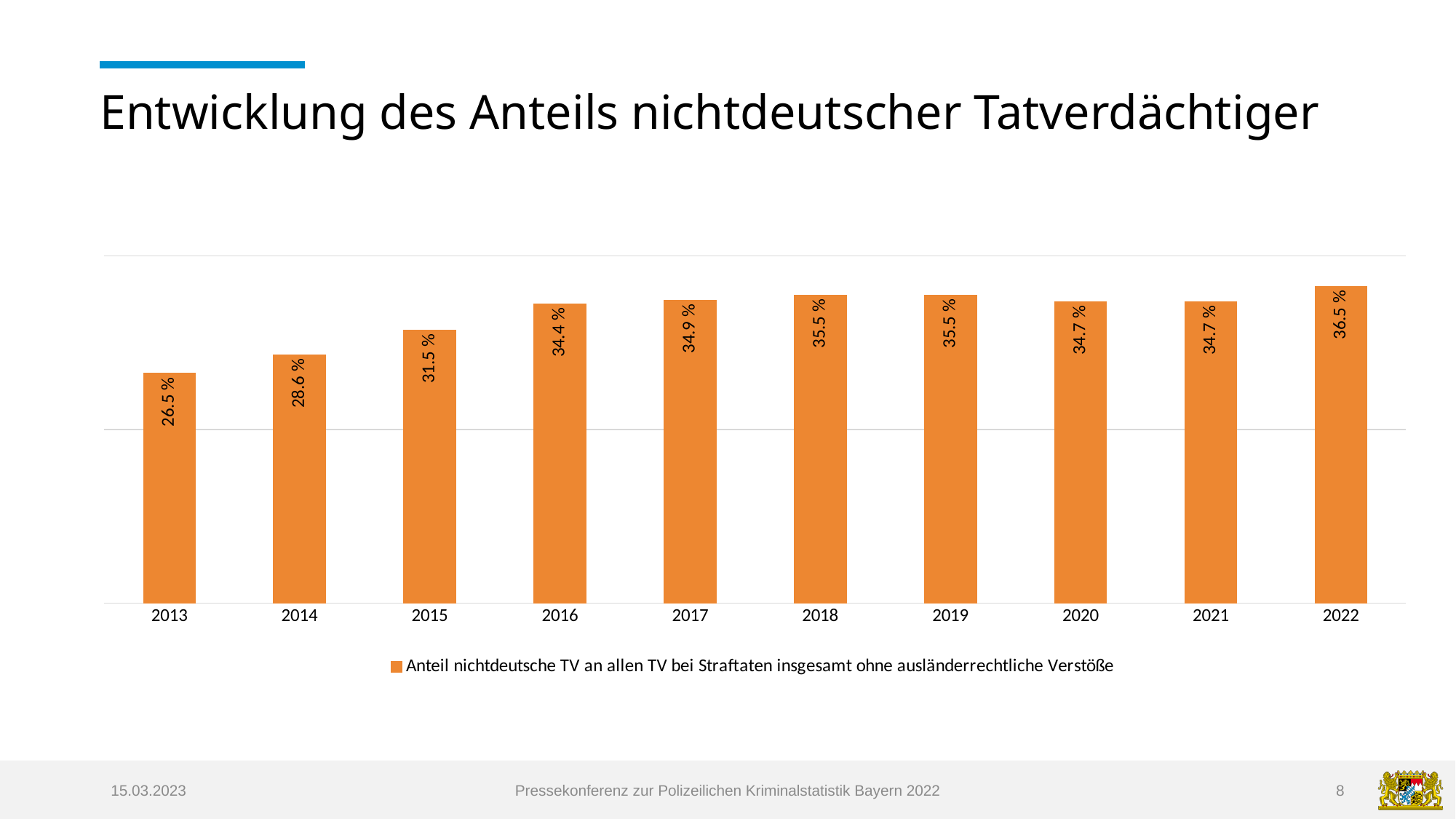
What kind of chart is shown on the slide? Bar chart How many series does the legend list? 1 What is the value for 2022? 36.5 % Do the values generally rise or fall from 2013 to 2022? Rise How many years are shown on the x axis? 10 Which is larger, the value for 2016 or the value for 2015? 2016 Which year has the lowest value? 2013 What is the difference between the values for 2022 and 2013? 10.0 percentage points What is the value for 2013? 26.5 % What is the difference between the values for 2015 and 2014? 2.9 percentage points Which year has the highest value? 2022 What is the value for 2018? 35.5 %